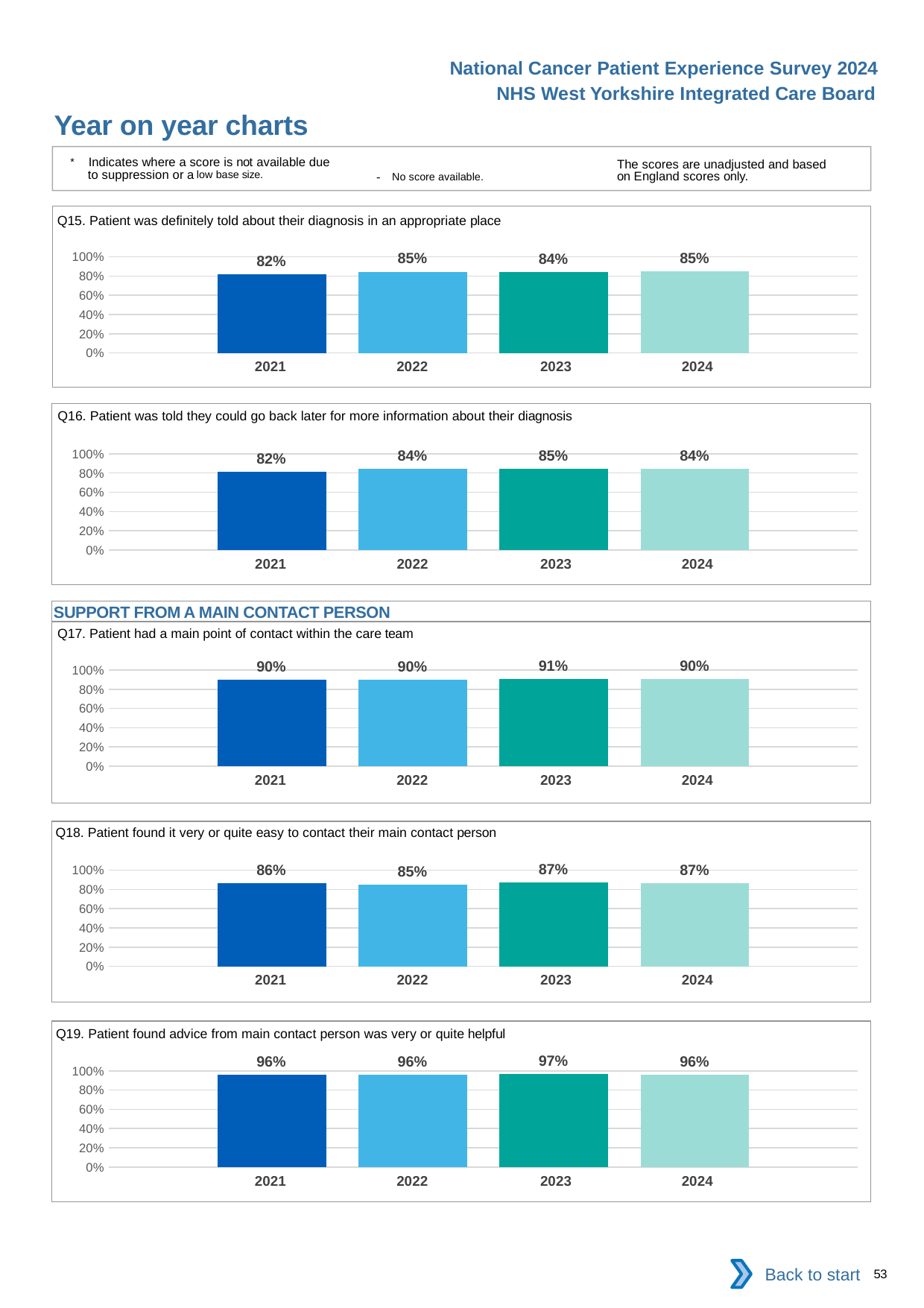
In the Q18 chart, what is the difference between the 2024 value and the 2022 value? 2% In the Q18 chart, which is larger, the value for 2021 or the value for 2022? 2021 In the Q15 chart, what is the value for 2022? 85% How many years are shown on the x axis of the Q15 chart? 4 How many charts are shown on the slide? 5 In the Q19 chart, what is the value for 2023? 97% In the Q16 chart, which year has the lowest value? 2021 In the Q15 chart, what is the difference between the 2021 value and the 2022 value? 3% In the Q16 chart, which year has the highest value? 2023 In the Q19 chart, is the value for 2021 greater or less than 80%? greater What kind of chart is the Q17 chart? bar chart In the Q17 chart, what is the value for 2023? 91%